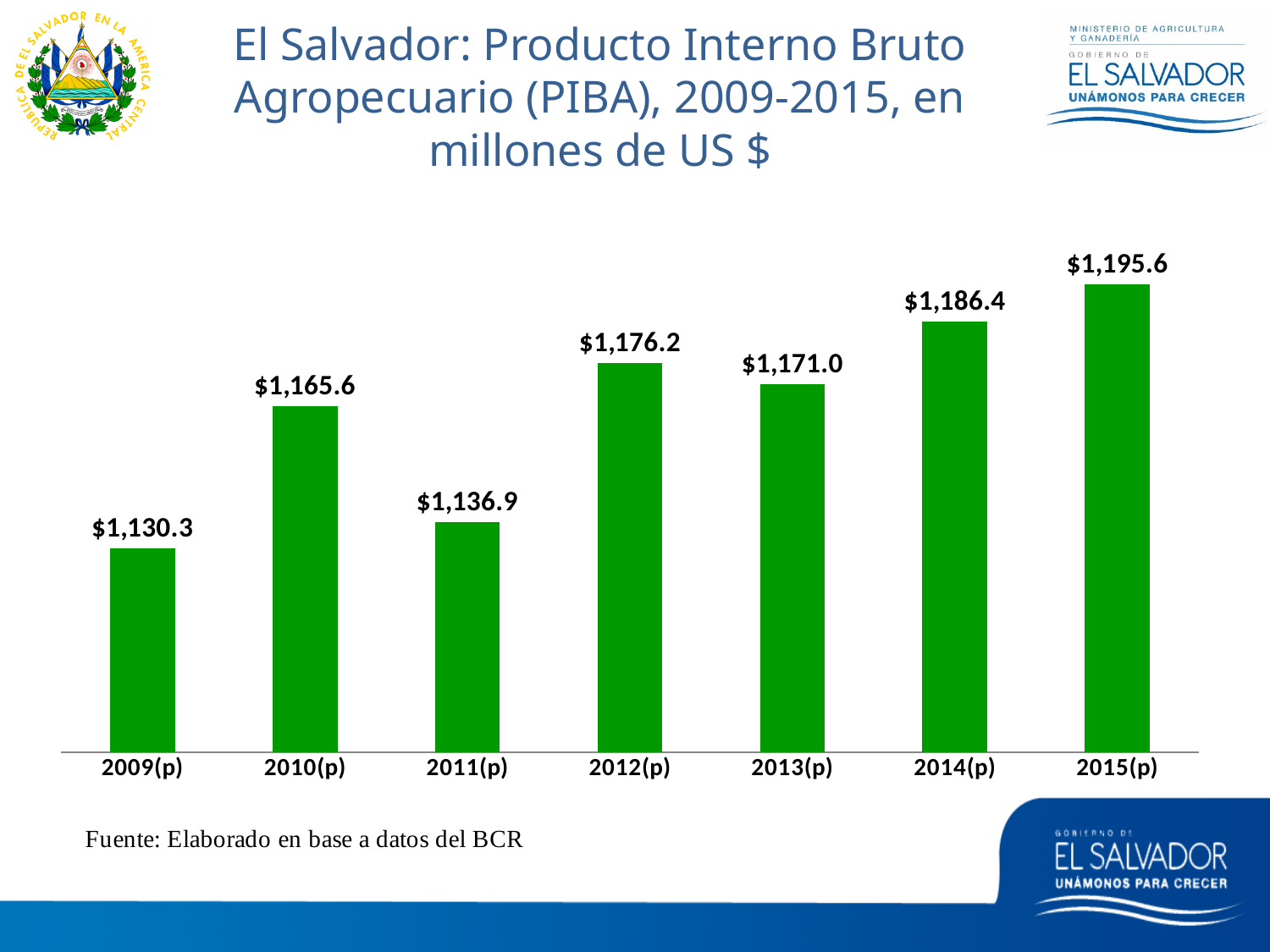
What is the difference between the values for 2015(p) and 2009(p)? $65.3 Which is larger, the value for 2010(p) or the value for 2011(p)? 2010(p) Which is larger, the value for 2012(p) or the value for 2013(p)? 2012(p) What kind of chart is shown on the slide? Bar chart How many years are shown on the x axis? 7 What is the value for 2009(p)? $1,130.3 Which year has the lowest value? 2009(p) What is the value for 2012(p)? $1,176.2 What is the value for 2014(p)? $1,186.4 What is the difference between the values for 2012(p) and 2011(p)? $39.3 From 2013(p) to 2015(p), do the values rise or fall? Rise Which year has the highest value? 2015(p)